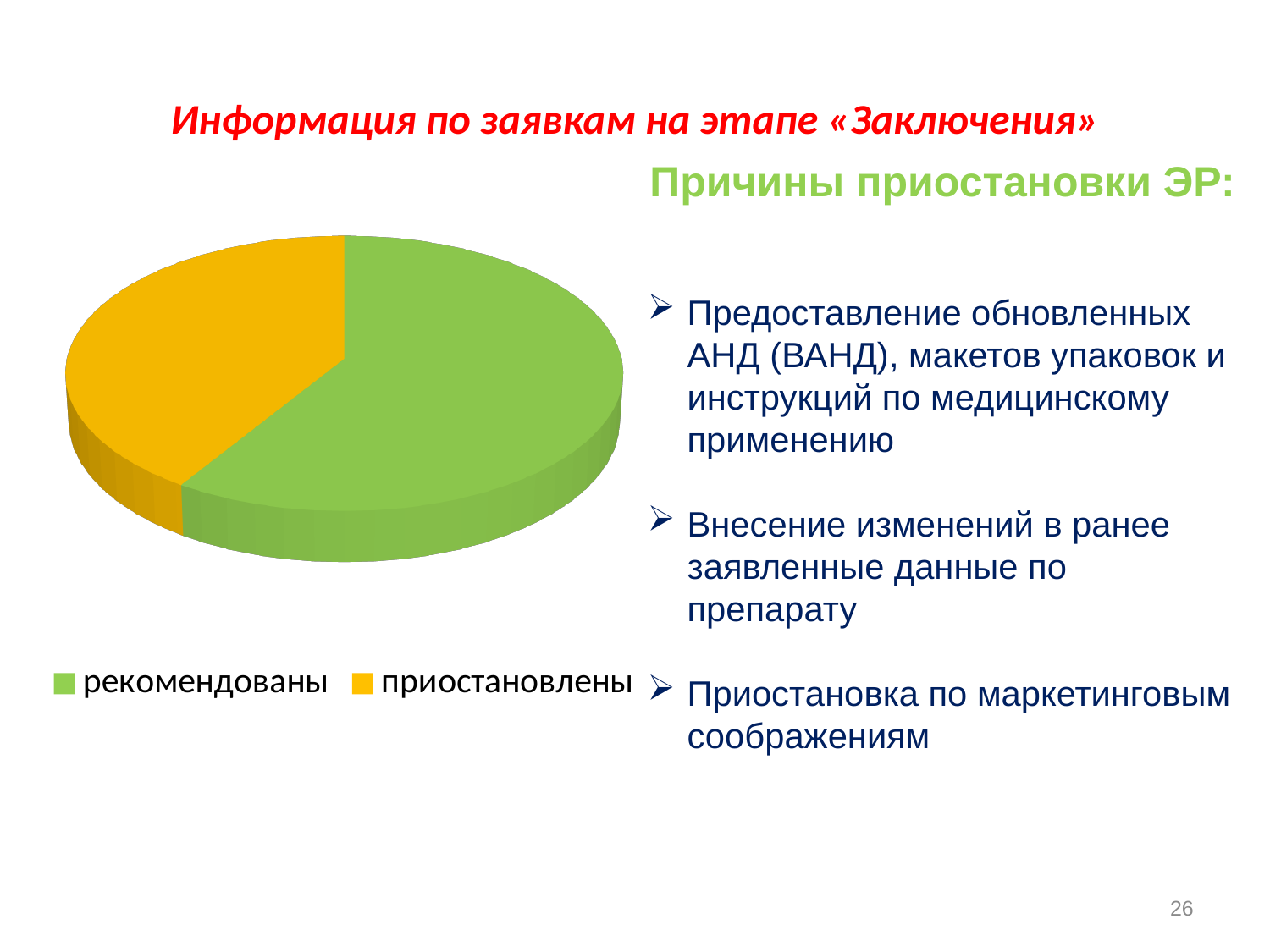
What colour is the slice for рекомендованы in the pie chart? green How many slices does the pie chart have? 2 How many entries does the legend of the pie chart list? 2 What colour is the slice for приостановлены in the pie chart? yellow Which category has the largest slice in the pie chart? рекомендованы Which category has the smallest slice in the pie chart? приостановлены What kind of chart is shown on the slide? pie chart Which slice is larger in the pie chart: рекомендованы or приостановлены? рекомендованы